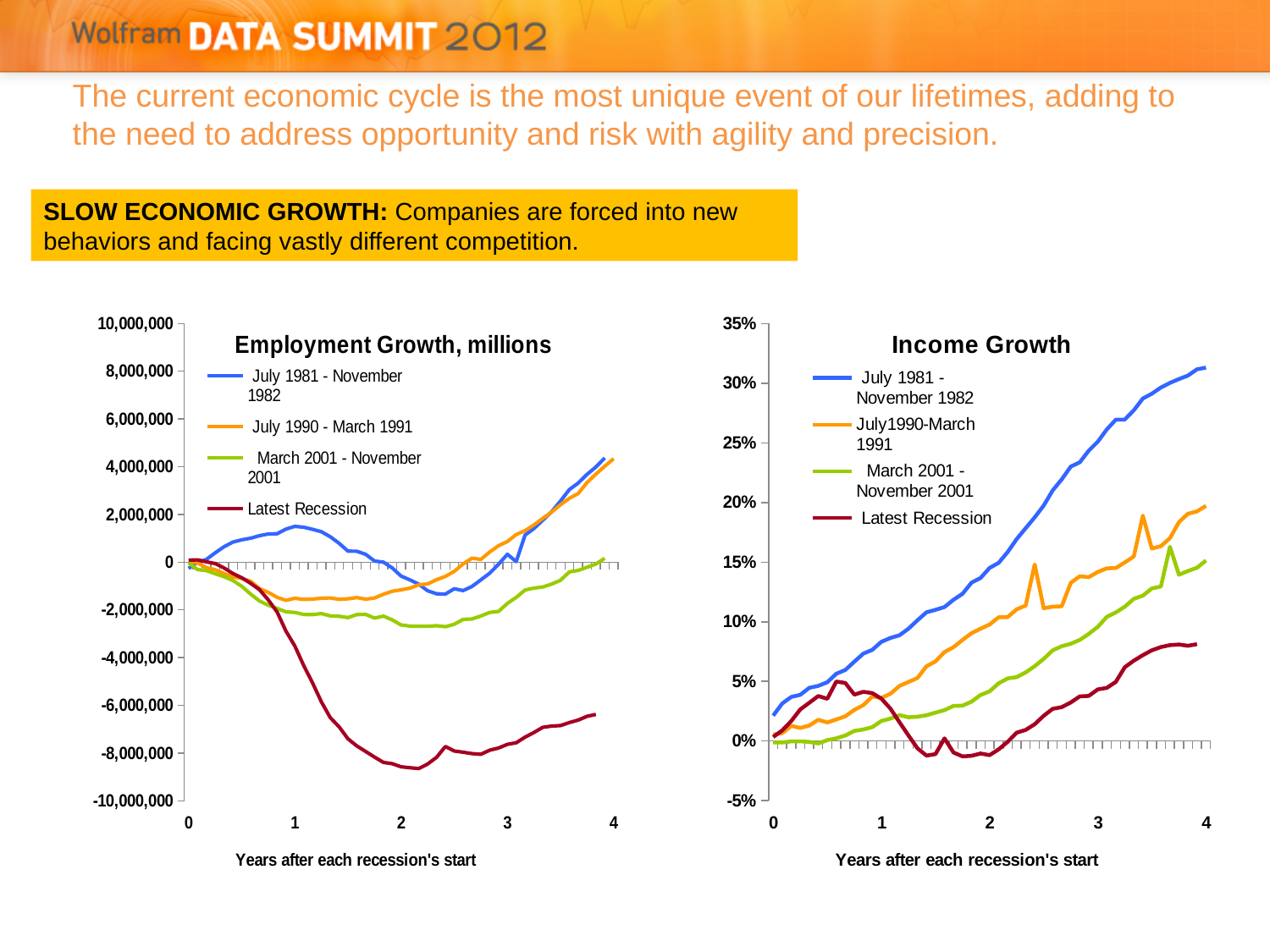
In the Income Growth chart, is the value for Latest Recession at 4 years greater or less than 10%? less In the Income Growth chart, does the July 1981 - November 1982 series rise or fall from 0 to 4 years? rise In the Employment Growth, millions chart, which is higher at 3 years: July 1981 - November 1982 or Latest Recession? July 1981 - November 1982 In the Employment Growth, millions chart, which series is lowest at 2 years after the recession's start? Latest Recession How many series does the legend of the Income Growth chart list? 4 In the Income Growth chart, which is larger at 1 year: July 1981 - November 1982 or Latest Recession? July 1981 - November 1982 In the Income Growth chart, is the value for July 1981 - November 1982 at 4 years greater or less than 25%? greater What is the x-axis label of the Income Growth chart? Years after each recession's start In the Employment Growth, millions chart, is the value for Latest Recession at 2 years greater or less than -6,000,000? less In the Income Growth chart, which series is highest at 3 years after the recession's start? July 1981 - November 1982 What kind of chart is the Employment Growth, millions chart? line chart